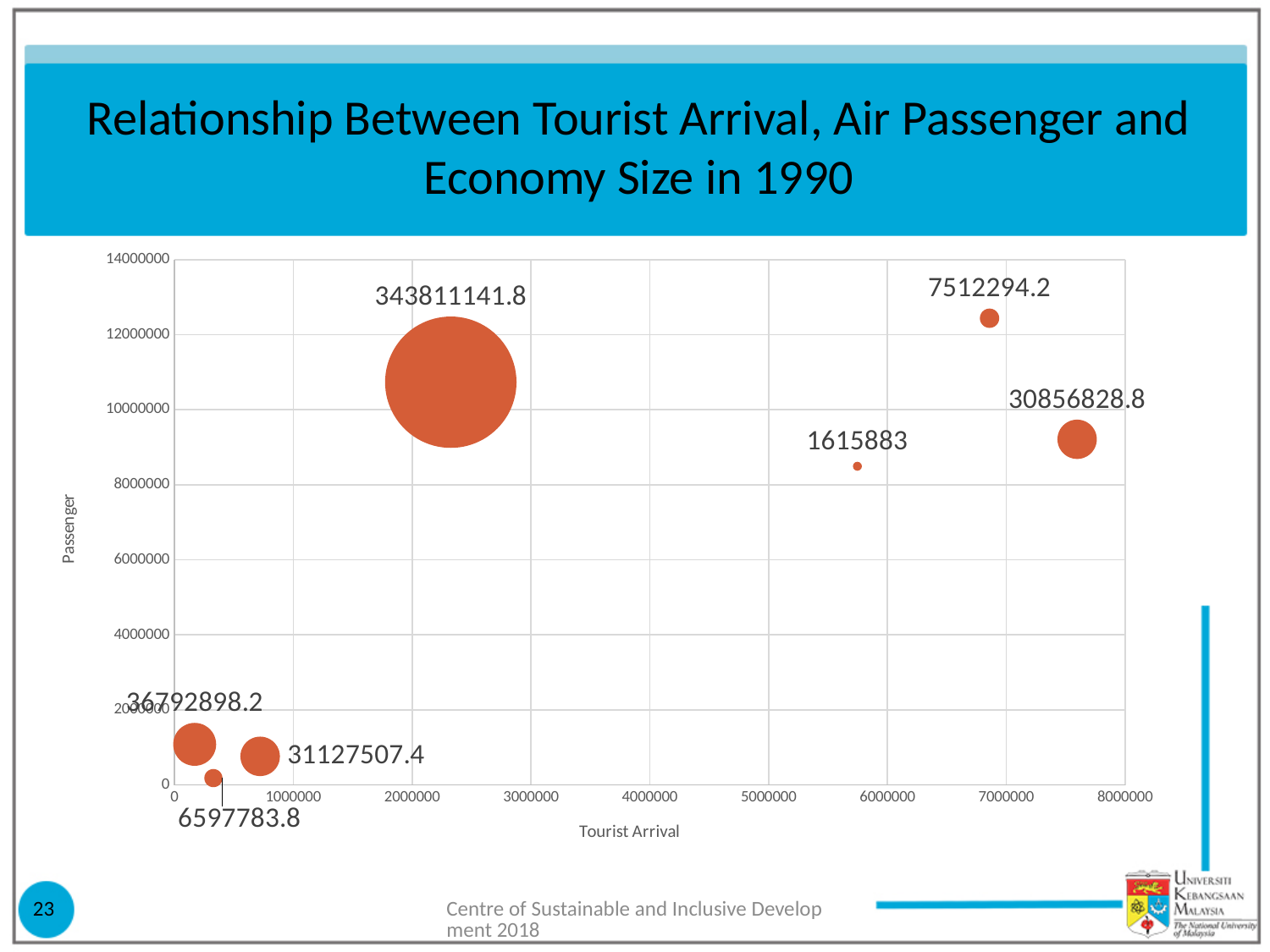
How many bubbles (data points) are plotted on the chart? 7 Which bubble has the higher Tourist Arrival value: the one labelled 343811141.8 or the one labelled 1615883? 1615883 Is the Tourist Arrival value for the bubble labelled 30856828.8 greater or less than 7000000? greater Is the Tourist Arrival value for the bubble labelled 36792898.2 greater or less than 1000000? less Is the Passenger value for the bubble labelled 7512294.2 greater or less than 12000000? greater What is the title of the chart on the slide? Relationship Between Tourist Arrival, Air Passenger and Economy Size in 1990 Which bubble has the higher Passenger value: the one labelled 7512294.2 or the one labelled 30856828.8? 7512294.2 What kind of chart is shown on the slide? Bubble chart Which data label belongs to the smallest bubble on the chart? 1615883 Which data label belongs to the largest bubble on the chart? 343811141.8 What is the label of the horizontal axis of the chart? Tourist Arrival